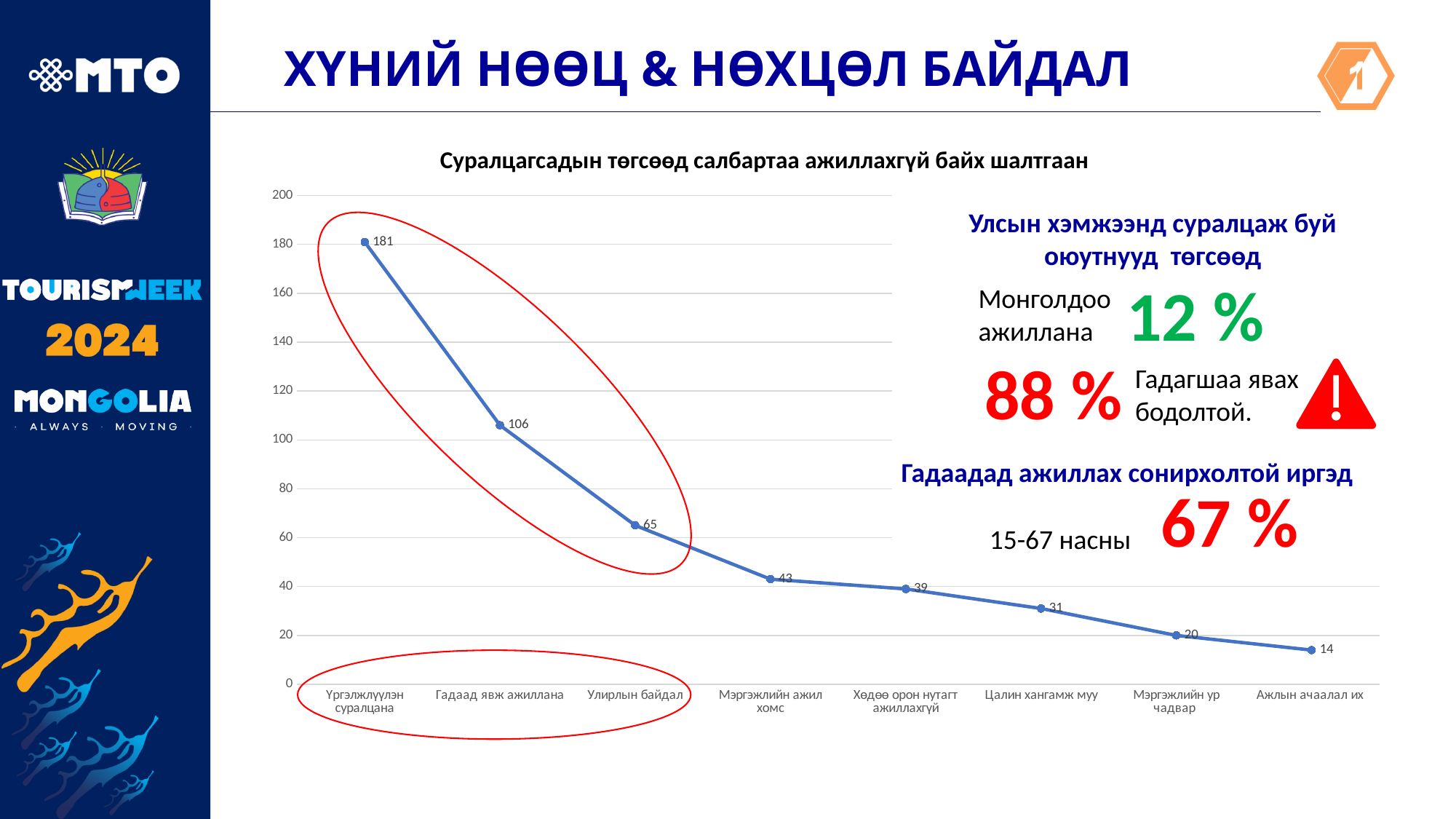
What is the value for Цалин хангамж муу? 31 Which category has the highest value? Үргэлжлүүлэн суралцана What is the difference between the values for Үргэлжлүүлэн суралцана and Гадаад явж ажиллана? 75 What is the value for Мэргэжлийн ажил хомс? 43 What is the value for Гадаад явж ажиллана? 106 Which category has the lowest value? Ажлын ачаалал их How many categories are plotted on the chart? 8 What is the value for Үргэлжлүүлэн суралцана? 181 What is the difference between the values for Улирлын байдал and Мэргэжлийн ур чадвар? 45 Do the values rise or fall from left to right along the x axis? Fall Which is larger, the value for Хөдөө орон нутагт ажиллахгүй or the value for Мэргэжлийн ур чадвар? Хөдөө орон нутагт ажиллахгүй What kind of chart is shown on the slide? Line chart